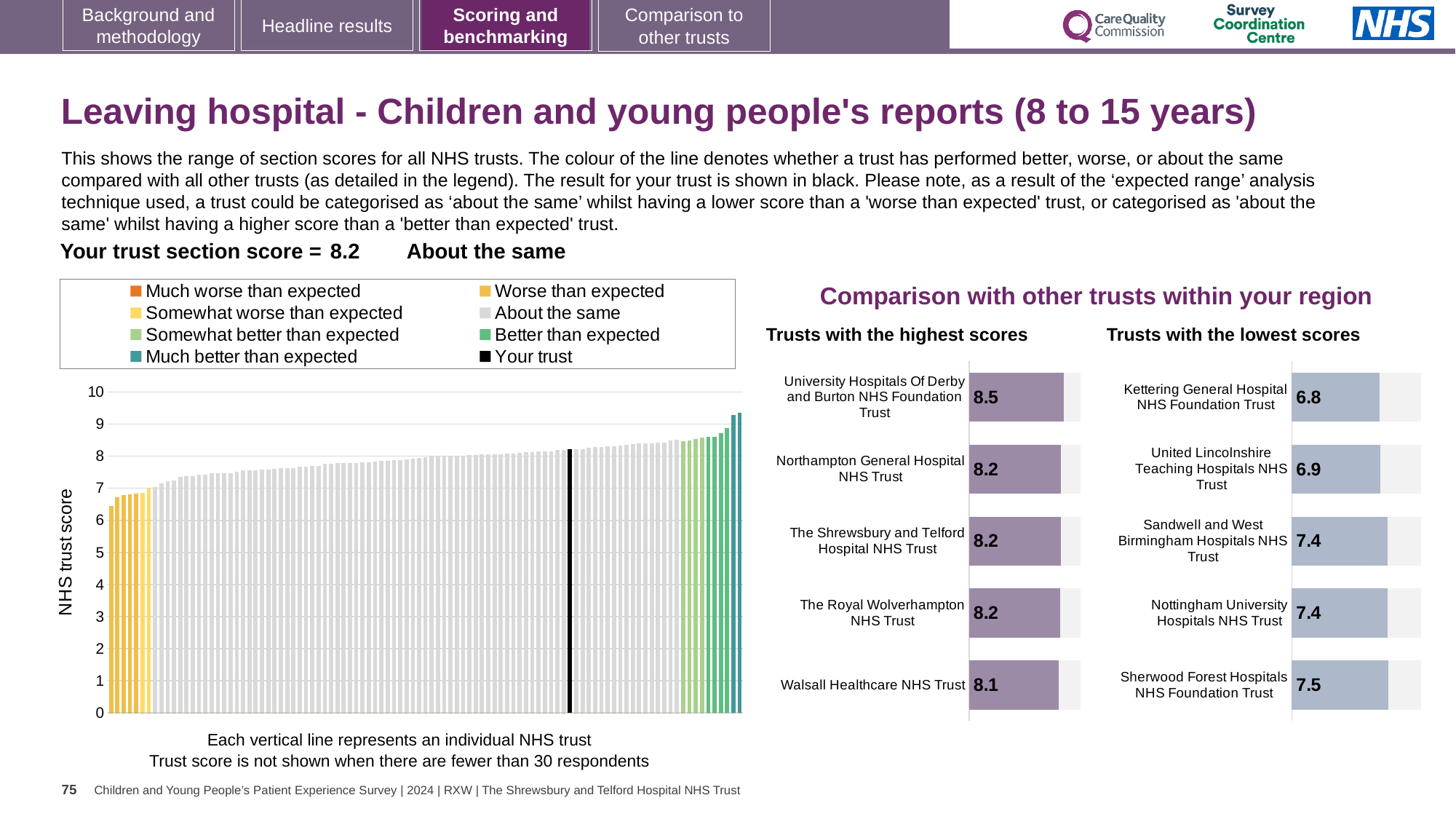
In the 'Trusts with the lowest scores' chart, what is the score for Kettering General Hospital NHS Foundation Trust? 6.8 In the 'Trusts with the lowest scores' chart, which trust has the highest score? Sherwood Forest Hospitals NHS Foundation Trust In the 'Trusts with the highest scores' chart, what is the difference between the scores of University Hospitals Of Derby and Burton NHS Foundation Trust and Walsall Healthcare NHS Trust? 0.4 In the left-hand NHS trust score chart, is the value of the black bar (your trust) greater or less than 8? greater In the 'Trusts with the highest scores' chart, which trust has the lowest score? Walsall Healthcare NHS Trust In the 'Trusts with the highest scores' chart, what is the score for University Hospitals Of Derby and Burton NHS Foundation Trust? 8.5 In the left-hand NHS trust score chart, do the bar values rise or fall from left to right? Rise What kind of chart is the large chart on the left showing NHS trust scores? Bar chart In the 'Trusts with the lowest scores' chart, which has the larger score: United Lincolnshire Teaching Hospitals NHS Trust or Nottingham University Hospitals NHS Trust? Nottingham University Hospitals NHS Trust How many trusts are listed in the 'Trusts with the highest scores' chart? 5 In the 'Trusts with the lowest scores' chart, what is the difference between the scores of Sherwood Forest Hospitals NHS Foundation Trust and Kettering General Hospital NHS Foundation Trust? 0.7 How many entries does the legend of the left-hand NHS trust score chart list? 8